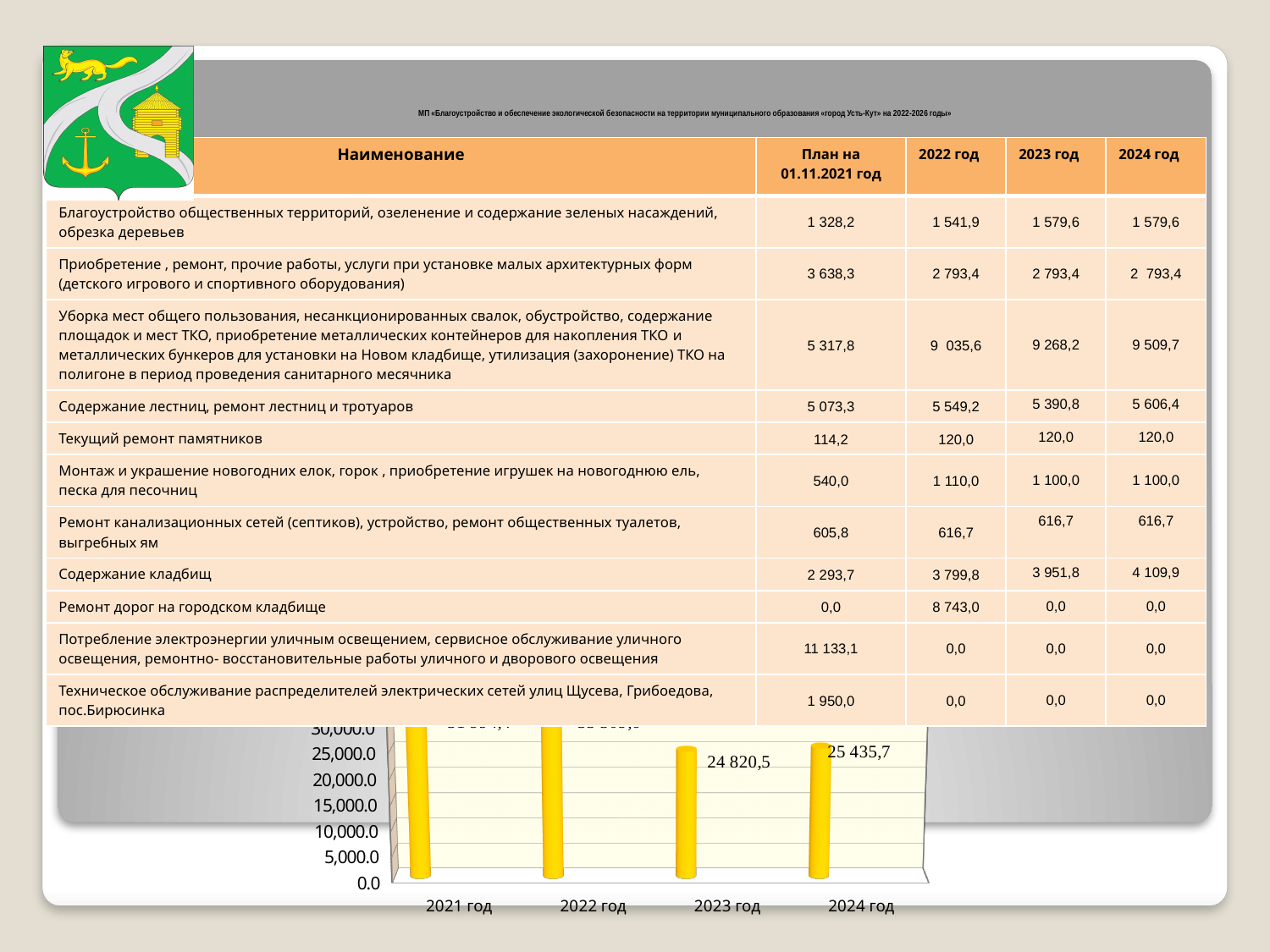
Is the value for 2023 год in the chart greater or less than 20,000? greater Is the value for 2021 год in the chart greater or less than 25,000? greater Does the value rise or fall from 2023 год to 2024 год in the chart? rise What is the difference between the values for 2024 год and 2023 год in the chart? 615,2 Which category has the lowest bar in the chart? 2023 год What is the value shown for 2024 год in the chart? 25 435,7 Which is larger in the chart, the value for 2023 год or the value for 2024 год? 2024 год What is the value shown for 2023 год in the chart? 24 820,5 How many categories are shown on the x axis of the chart? 4 Is the value for 2022 год in the chart greater or less than 25,000? greater What kind of chart is shown at the bottom of the slide? bar chart What colour are the bars in the chart? yellow